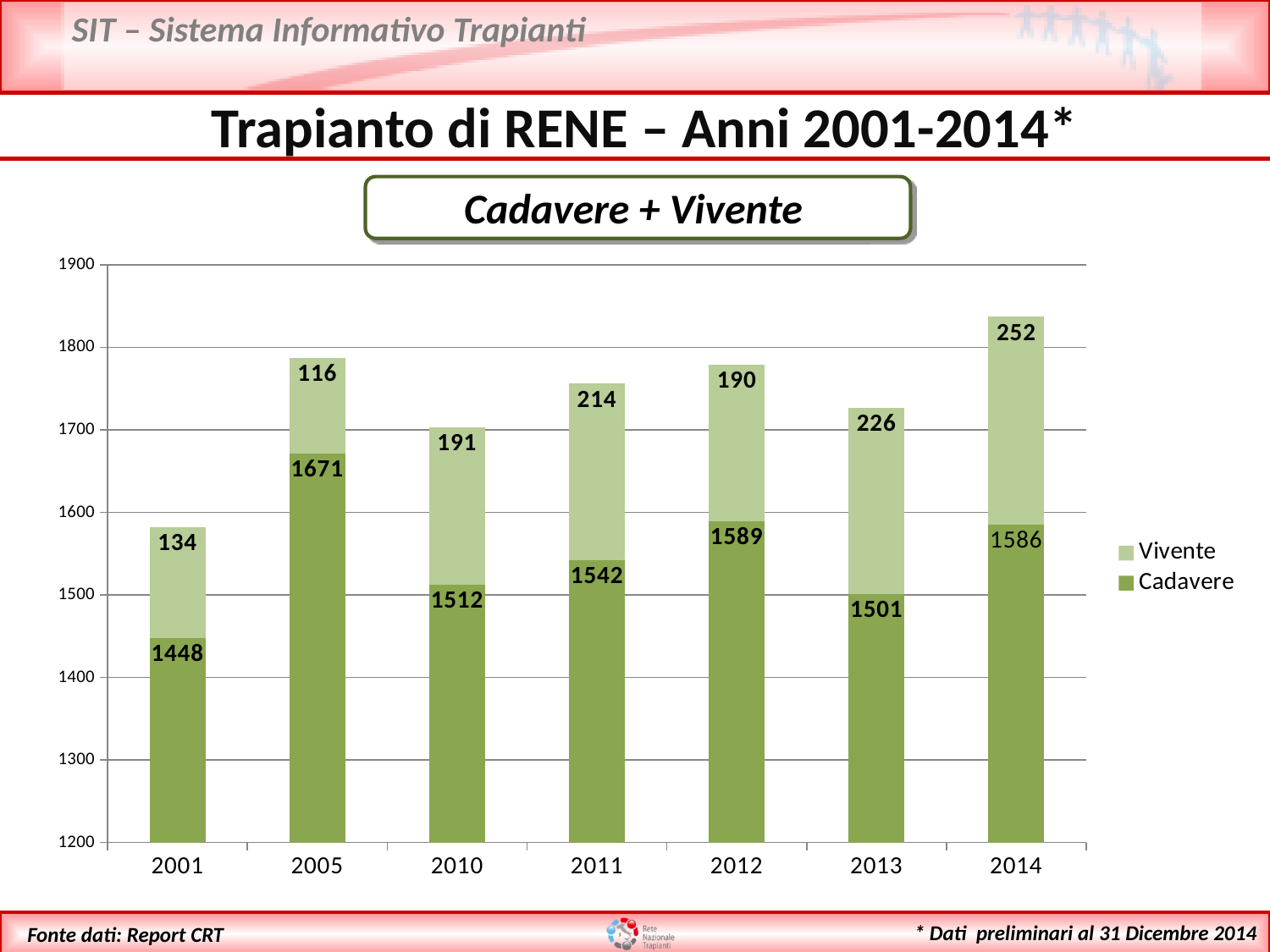
What is the title shown in the box above the chart? Cadavere + Vivente What is the total of the stacked bar for 2014 (Cadavere plus Vivente)? 1838 What is the Cadavere value for 2013? 1501 Which year has the lowest Cadavere value? 2001 What is the Vivente value for 2014? 252 How many series does the legend list? 2 What is the Cadavere value for 2005? 1671 Which is larger, the Vivente value for 2011 or for 2012? 2011 What is the difference between the Cadavere values for 2012 and 2010? 77 How many years are shown on the x axis? 7 What kind of chart is shown? Stacked bar chart Which year has the highest Vivente value? 2014